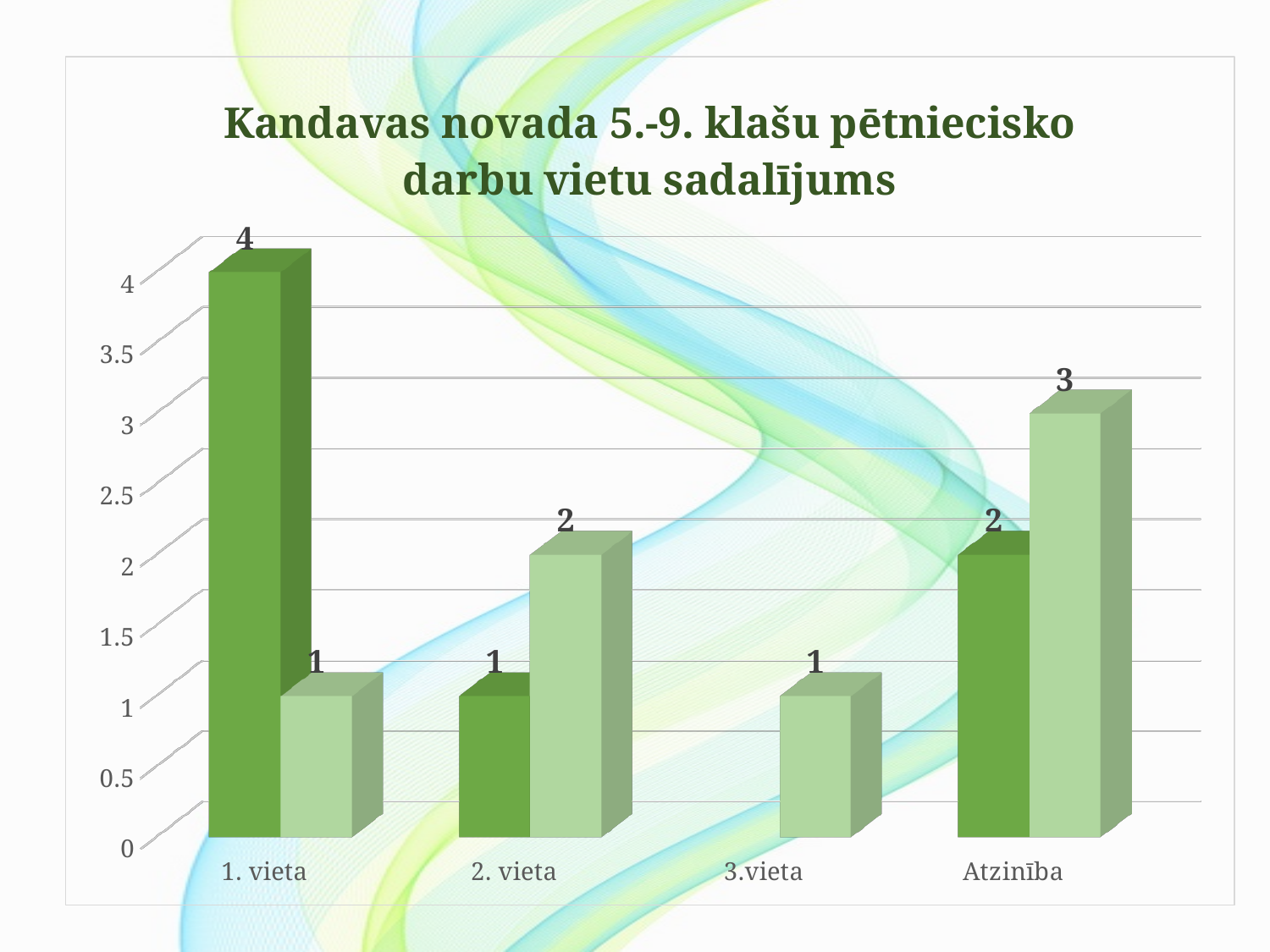
How many categories are shown on the x axis of the chart? 4 Which is larger for Atzinība: the dark green bar or the light green bar? the light green bar Which category has the lowest light green bar? 1. vieta and 3.vieta (both 1) What is the difference between the dark green bar for 1. vieta and the dark green bar for Atzinība? 2 What is the value of the light green bar for 2. vieta? 2 What type of chart is shown on the slide? bar chart What is the value of the light green bar for 3.vieta? 1 What is the value of the dark green bar for 1. vieta? 4 Is the value of the dark green bar for 1. vieta greater or less than 3? greater What is the value of the light green bar for Atzinība? 3 Which category has the highest dark green bar? 1. vieta What is the title of the chart? Kandavas novada 5.-9. klašu pētniecisko darbu vietu sadalījums